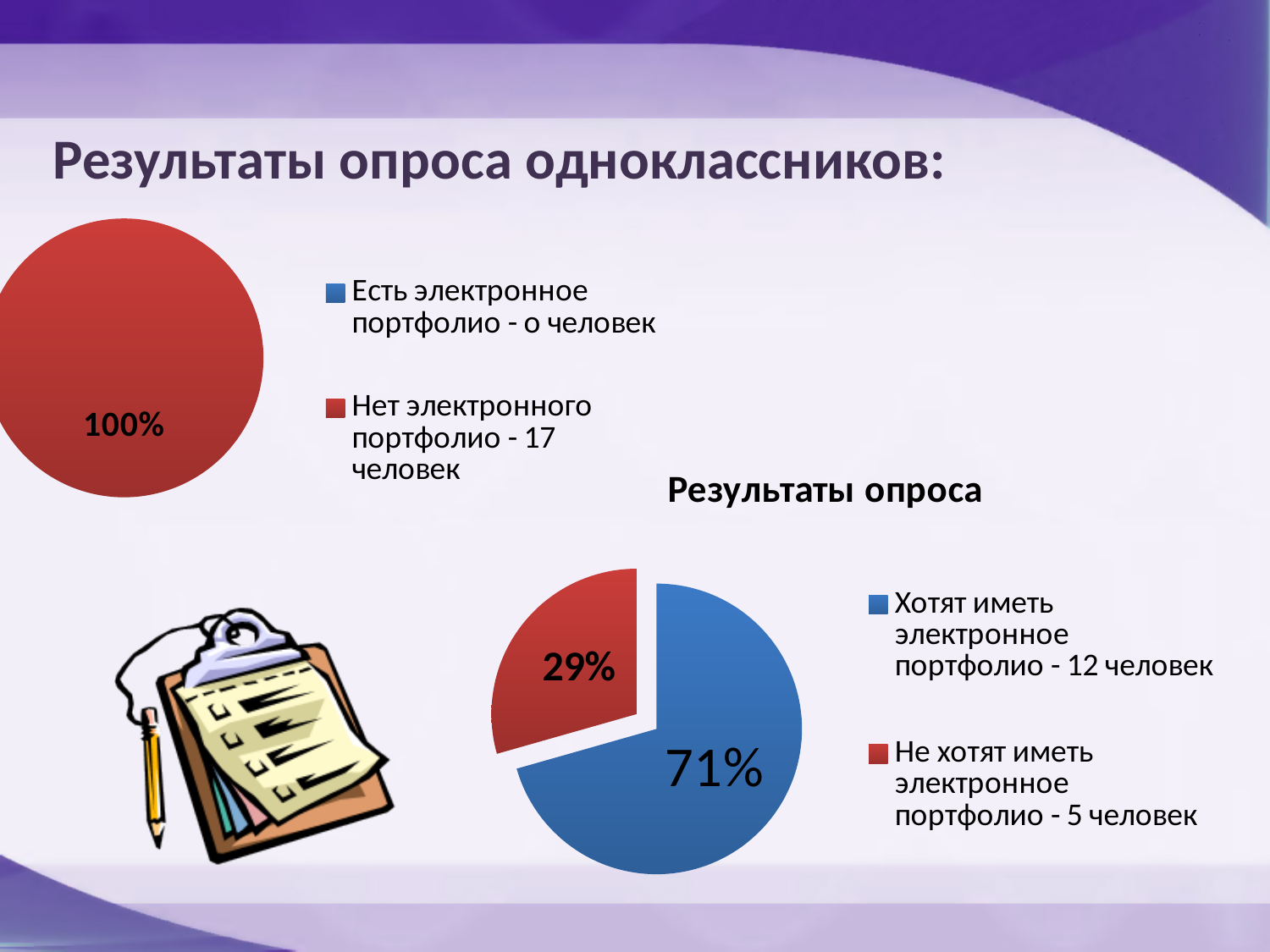
In the top-left pie chart, which legend entry corresponds to the red slice? Нет электронного портфолио - 17 человек What type of chart is the chart titled "Результаты опроса" at the bottom of the slide? pie chart In the chart titled "Результаты опроса", what is the difference in percentage points between the 71% slice and the 29% slice? 42 What type of chart is the chart in the top-left of the slide? pie chart In the chart titled "Результаты опроса", which slice is larger: "Хотят иметь электронное портфолио" or "Не хотят иметь электронное портфолио"? Хотят иметь электронное портфолио In the chart titled "Результаты опроса", what colour is the slice for "Не хотят иметь электронное портфолио - 5 человек"? red In the top-left pie chart, which category has the largest share? Нет электронного портфолио - 17 человек In the chart titled "Результаты опроса", what share of the pie is labelled for "Хотят иметь электронное портфолио - 12 человек"? 71% In the top-left pie chart, what percentage label is shown on the red slice? 100% In the chart titled "Результаты опроса", what share of the pie is labelled for "Не хотят иметь электронное портфолио - 5 человек"? 29% How many entries does the legend of the top-left pie chart list? 2 How many entries does the legend of the chart titled "Результаты опроса" list? 2